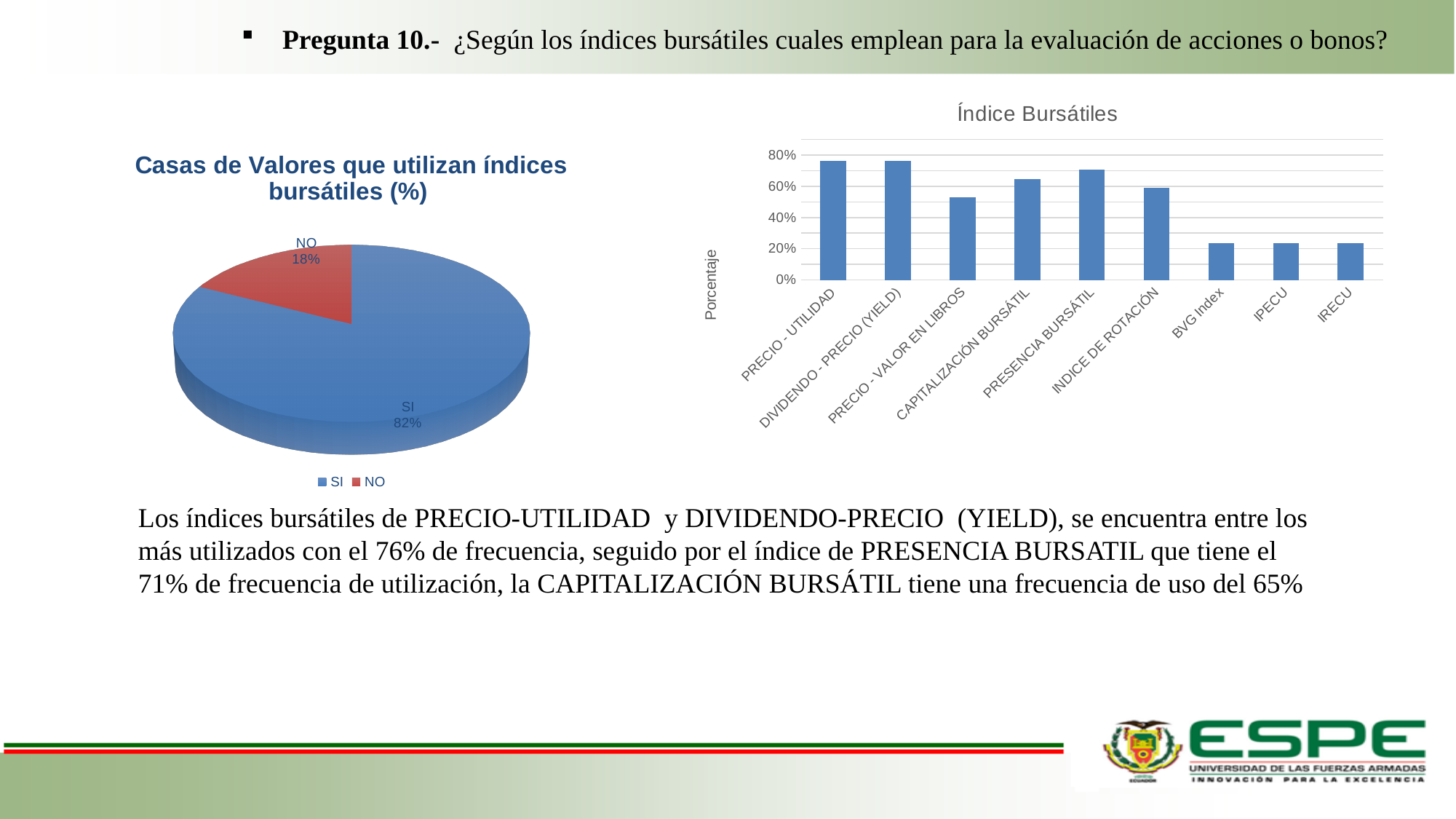
In the chart 'Índice Bursátiles', which is larger, PRESENCIA BURSÁTIL or CAPITALIZACIÓN BURSÁTIL? PRESENCIA BURSÁTIL In the chart 'Índice Bursátiles', is the value for BVG Index greater or less than 40%? less In the pie chart 'Casas de Valores que utilizan índices bursátiles (%)', which slice is the largest? SI In the pie chart 'Casas de Valores que utilizan índices bursátiles (%)', how many entries does the legend list? 2 In the chart 'Índice Bursátiles', what is the label of the y axis? Porcentaje In the pie chart 'Casas de Valores que utilizan índices bursátiles (%)', what is the value for NO? 18% In the chart 'Índice Bursátiles', how many categories are shown on the x axis? 9 In the chart 'Índice Bursátiles', is the value for PRECIO - VALOR EN LIBROS greater or less than 40%? greater In the pie chart 'Casas de Valores que utilizan índices bursátiles (%)', what is the difference between the SI and NO shares? 64% In the pie chart 'Casas de Valores que utilizan índices bursátiles (%)', what is the value for SI? 82% What kind of chart is the chart titled 'Índice Bursátiles'? Bar chart What kind of chart is the chart on the left of the slide? Pie chart